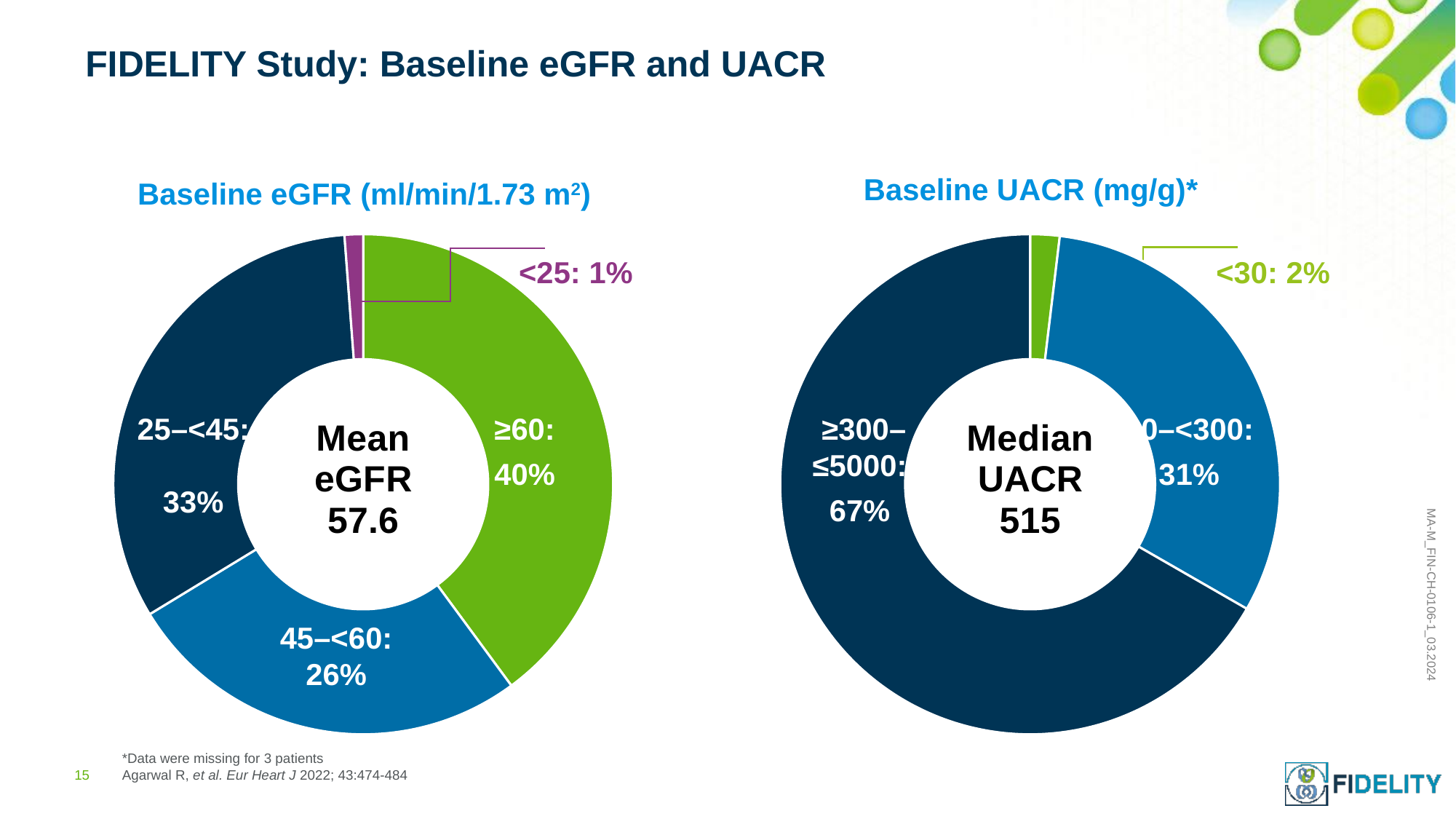
In the Baseline eGFR chart, which eGFR category has the largest share? ≥60 In the Baseline eGFR chart, what percentage of patients had eGFR 25–<45? 33% How many categories are shown in the Baseline eGFR chart? 4 In the Baseline UACR chart, what percentage of patients had UACR <30? 2% In the Baseline eGFR chart, what percentage of patients had eGFR <25? 1% What mean eGFR value is shown in the centre of the Baseline eGFR chart? 57.6 In the Baseline UACR chart, what percentage of patients had UACR ≥300–≤5000? 67% What median UACR value is shown in the centre of the Baseline UACR chart? 515 In the Baseline eGFR chart, what percentage of patients had eGFR ≥60? 40% In the Baseline eGFR chart, what is the difference in percentage points between the 25–<45 and 45–<60 categories? 7 In the Baseline eGFR chart, which eGFR category has the smallest share? <25 What kind of chart is used for Baseline eGFR? Pie (donut) chart